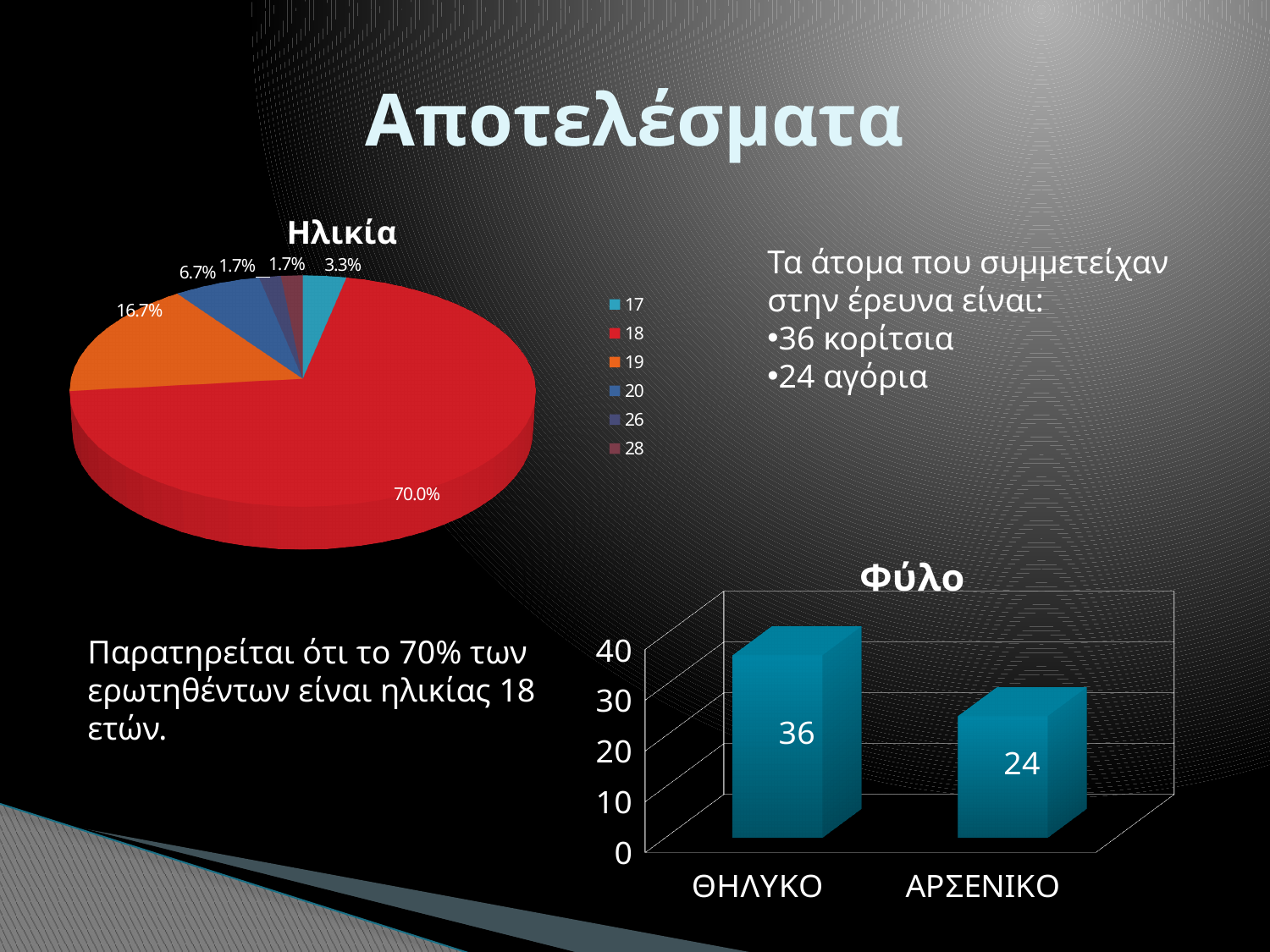
In the Ηλικία pie chart, what share of respondents are age 19? 16.7% In the Φύλο chart, which category has the higher value, ΘΗΛΥΚΟ or ΑΡΣΕΝΙΚΟ? ΘΗΛΥΚΟ How many entries does the legend of the Ηλικία pie chart list? 6 What kind of chart is the Ηλικία chart? pie chart In the Φύλο chart, what is the difference between ΘΗΛΥΚΟ and ΑΡΣΕΝΙΚΟ? 12 In the Φύλο chart, what is the value for ΘΗΛΥΚΟ? 36 In the Ηλικία pie chart, what share of respondents are age 20? 6.7% In the Ηλικία pie chart, which age has the largest slice? 18 In the Ηλικία pie chart, what share of respondents are age 17? 3.3% What kind of chart is the Φύλο chart? bar chart In the Ηλικία pie chart, what share of respondents are age 18? 70.0% In the Φύλο chart, what is the value for ΑΡΣΕΝΙΚΟ? 24